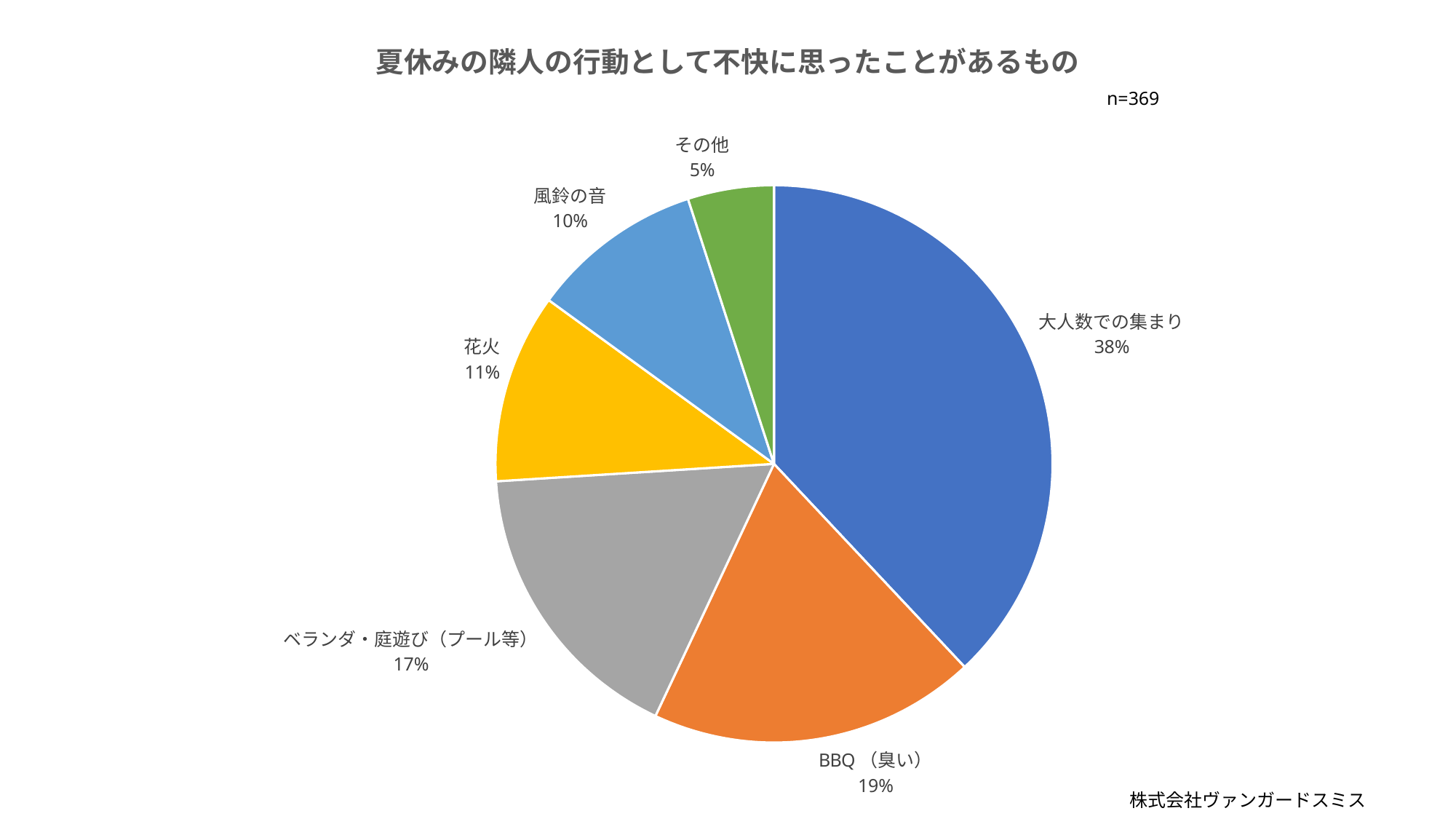
What is the title of the chart? 夏休みの隣人の行動として不快に思ったことがあるもの What is the value shown for 風鈴の音? 10% What sample size (n) is shown on the slide? n=369 What is the value shown for ベランダ・庭遊び（プール等）? 17% What is the value shown for BBQ（臭い）? 19% How many categories are shown in the pie chart? 6 What kind of chart is shown on the slide? Pie chart Which category has the largest slice? 大人数での集まり Which category has the smallest slice? その他 What is the difference between 大人数での集まり and BBQ（臭い）? 19% What share of the pie does 大人数での集まり take? 38% Which is larger, 花火 or 風鈴の音? 花火